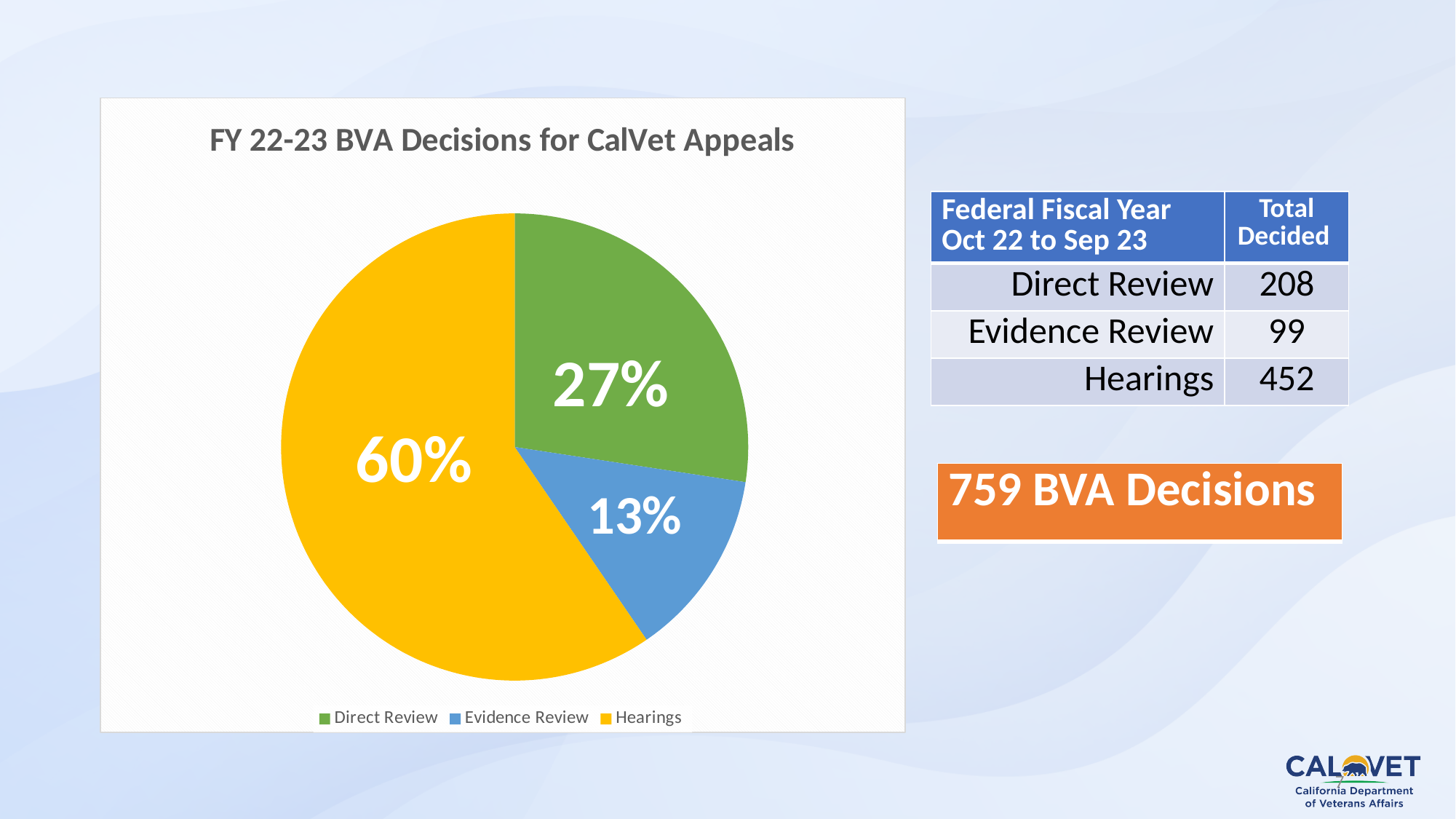
What percentage of the pie does Hearings represent? 60% What is the difference in percentage points between the Hearings slice and the Direct Review slice? 33 percentage points How many entries does the legend list? 3 What is the title of the chart? FY 22-23 BVA Decisions for CalVet Appeals Which slice is larger, Direct Review or Evidence Review? Direct Review What type of chart is shown on the slide? Pie chart What percentage of the pie does Evidence Review represent? 13% What percentage of the pie does Direct Review represent? 27% What colour is the Hearings slice in the pie chart? Yellow Which category has the largest slice of the pie? Hearings How many categories are shown in the pie chart? 3 Which category has the smallest slice of the pie? Evidence Review